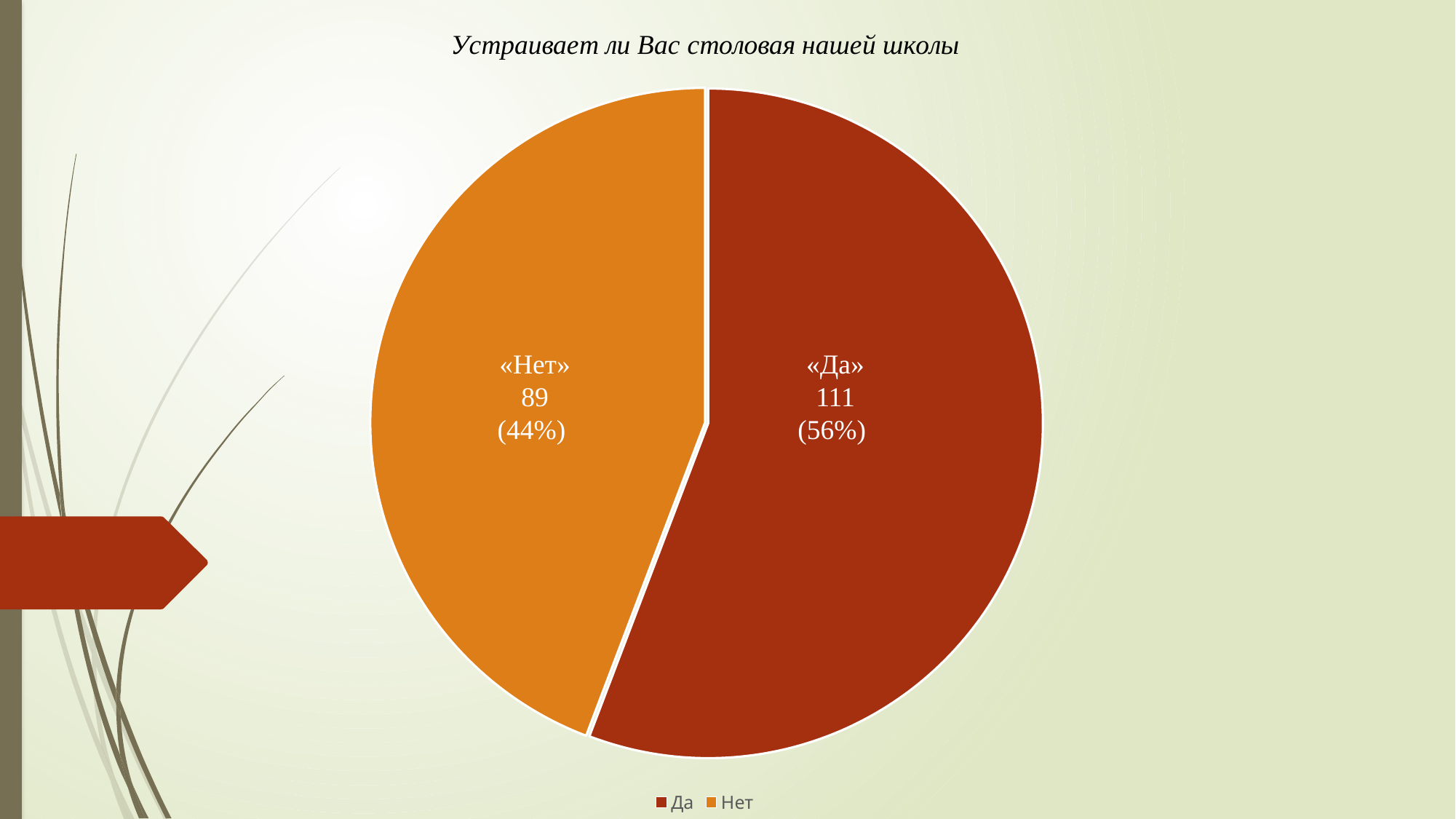
What is the difference between the values for «Да» and «Нет»? 22 What share of the pie does «Да» represent? 56% What is the title of the chart? Устраивает ли Вас столовая нашей школы What kind of chart is shown on the slide? pie chart What is the total of all slices in the pie chart? 200 What is the value for «Да»? 111 What is the value for «Нет»? 89 Which is larger, the value for «Да» or the value for «Нет»? Да How many slices does the pie chart have? 2 What share of the pie does «Нет» represent? 44% Which category has the highest value? Да Which category has the lowest value? Нет